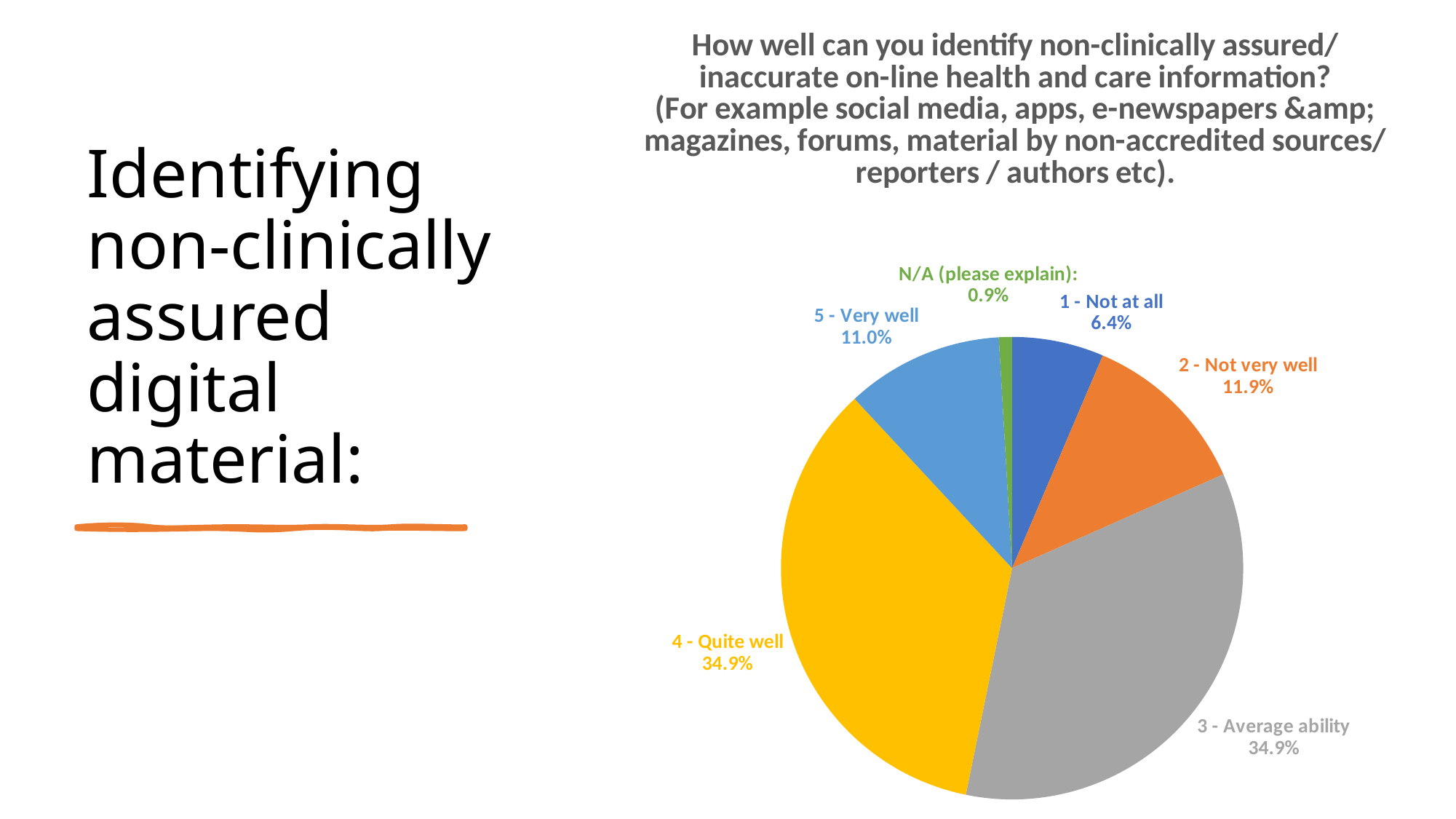
What percentage of respondents answered "5 - Very well"? 11.0% What kind of chart is shown on the slide? pie chart What percentage is shown for the "N/A (please explain):" slice? 0.9% What is the difference between the percentages for "2 - Not very well" and "1 - Not at all"? 5.5% What percentage of respondents answered "2 - Not very well"? 11.9% What is the combined percentage for "3 - Average ability" and "4 - Quite well"? 69.8% Which category has the smallest slice of the pie? N/A (please explain): What colour is the "3 - Average ability" slice? grey How many slices does the pie chart have? 6 What percentage of respondents answered "4 - Quite well"? 34.9% Which is larger, the slice for "5 - Very well" or the slice for "1 - Not at all"? 5 - Very well What percentage of respondents answered "1 - Not at all"? 6.4%